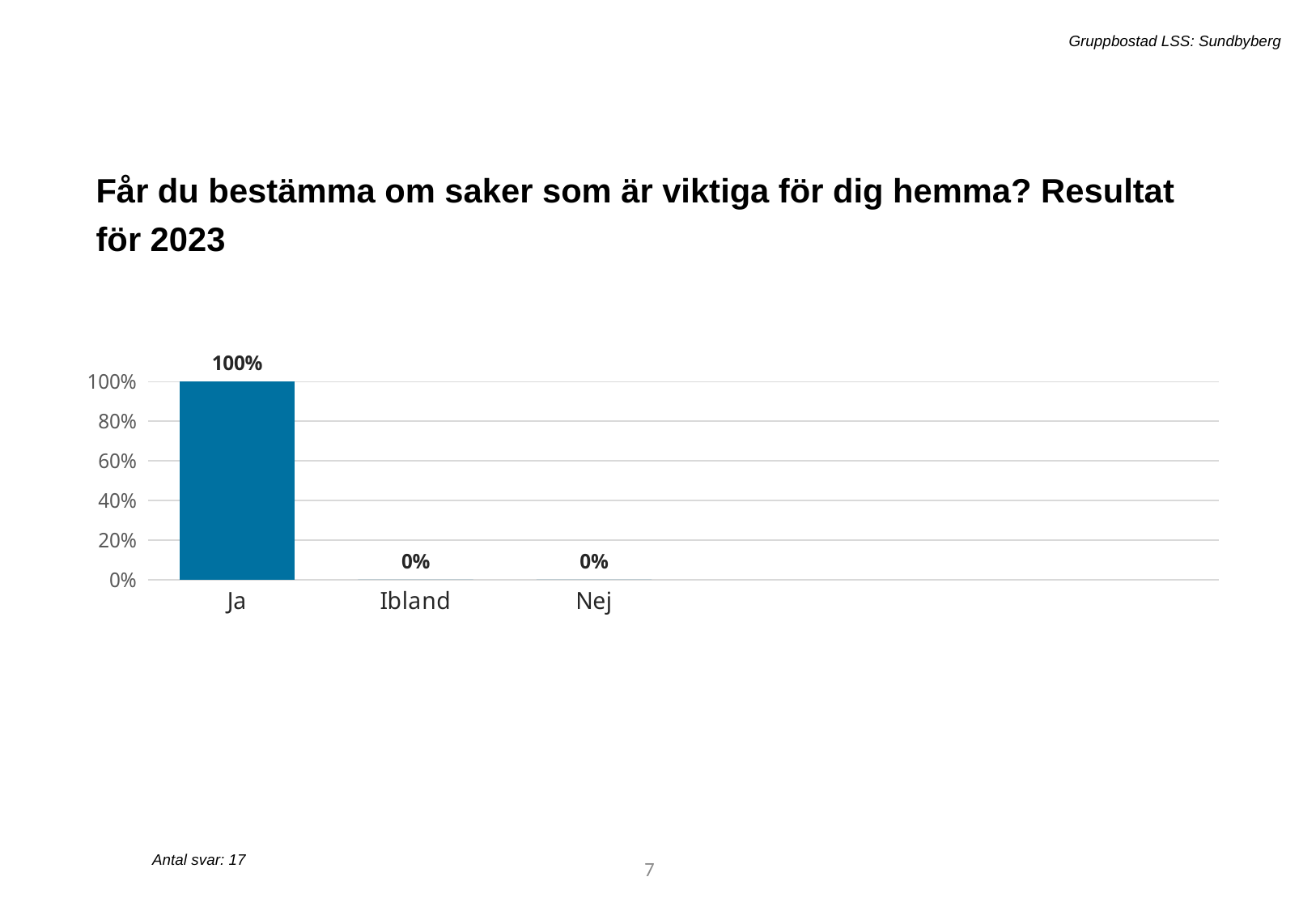
Do the values rise or fall from Ja to Nej along the x axis? fall What is the value for Nej? 0% What is the total of the values for Ja, Ibland and Nej? 100% What is the value for Ibland? 0% Which category has the highest value? Ja What is the difference between the values for Ja and Nej? 100% What is the value for Ja? 100% How many categories are shown on the x axis? 3 How many responses (Antal svar) does the slide report? 17 What kind of chart is shown on the slide? bar chart Is the value for Ja greater or less than 80%? greater Which is larger, the value for Ja or the value for Ibland? Ja